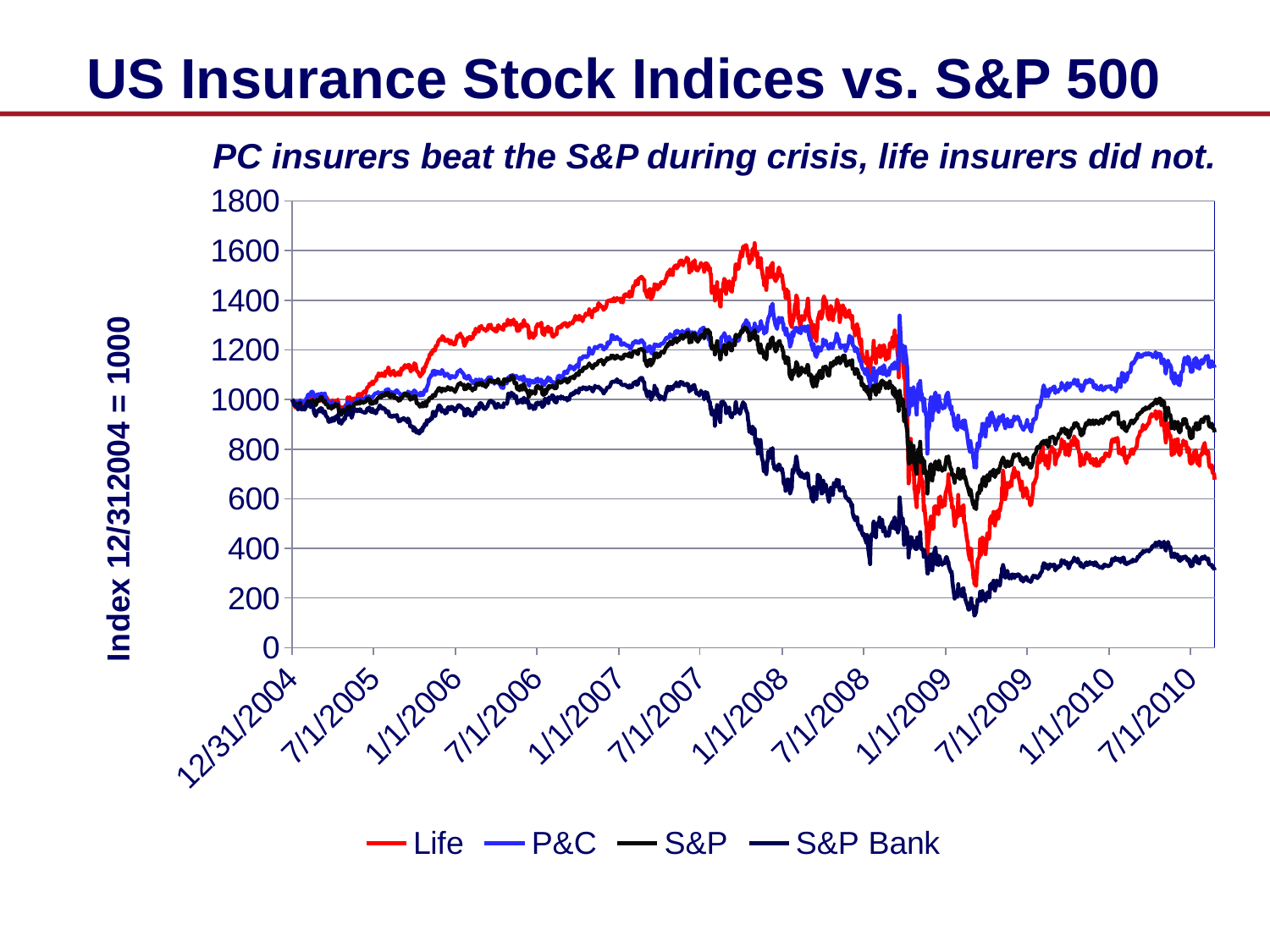
Is the value of the Life series at 1/1/2008 greater or less than 1200? greater Is the value of the P&C series at 7/1/2010 greater or less than 1000? greater What kind of chart is shown on the slide? Line chart At 7/1/2010, which is higher, the P&C series or the Life series? P&C What are the four series named in the legend? Life, P&C, S&P, S&P Bank Does the S&P Bank series rise or fall between 1/1/2008 and 1/1/2009? Fall Which series is lowest at the right end of the chart (7/1/2010)? S&P Bank Which series reaches the highest peak on the chart? Life What is the label on the vertical axis? Index 12/312004 = 1000 How many series does the legend list? 4 What is the index value of every series at 12/31/2004? 1000 Is the value of the S&P Bank series at 7/1/2010 greater or less than 600? less